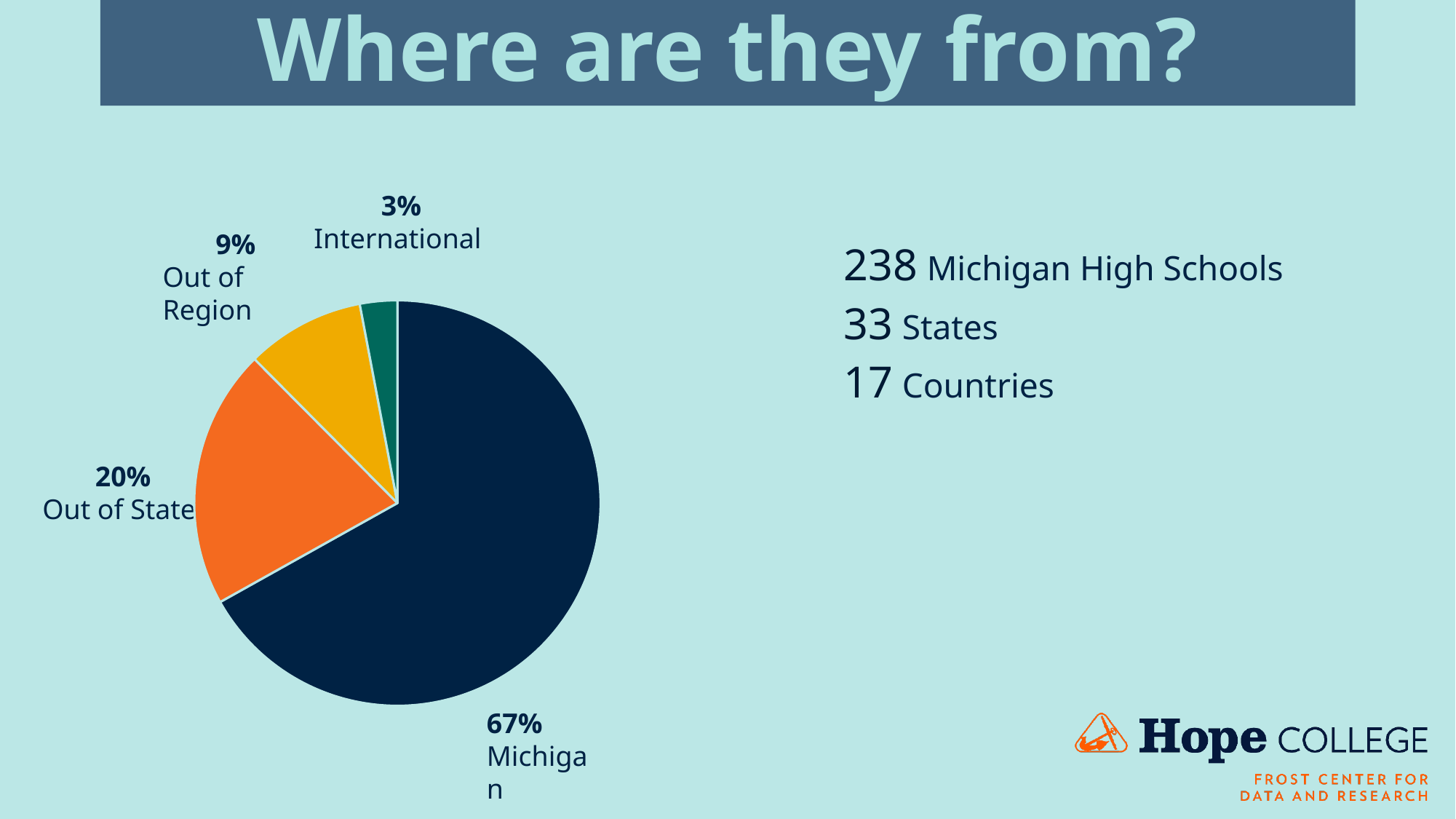
Which category has the largest share of the pie? Michigan What is the title of the slide containing the pie chart? Where are they from? Which is larger, Out of Region or International? Out of Region What type of chart is shown on the slide? pie chart What is the difference in percentage points between Michigan and Out of State? 47 What percentage of the pie is Out of State? 20% How many categories are shown in the pie chart? 4 What is the difference in percentage points between Out of State and Out of Region? 11 What percentage of the pie is International? 3% Which category has the smallest share of the pie? International What percentage of the pie is Out of Region? 9% What percentage of the pie is Michigan? 67%